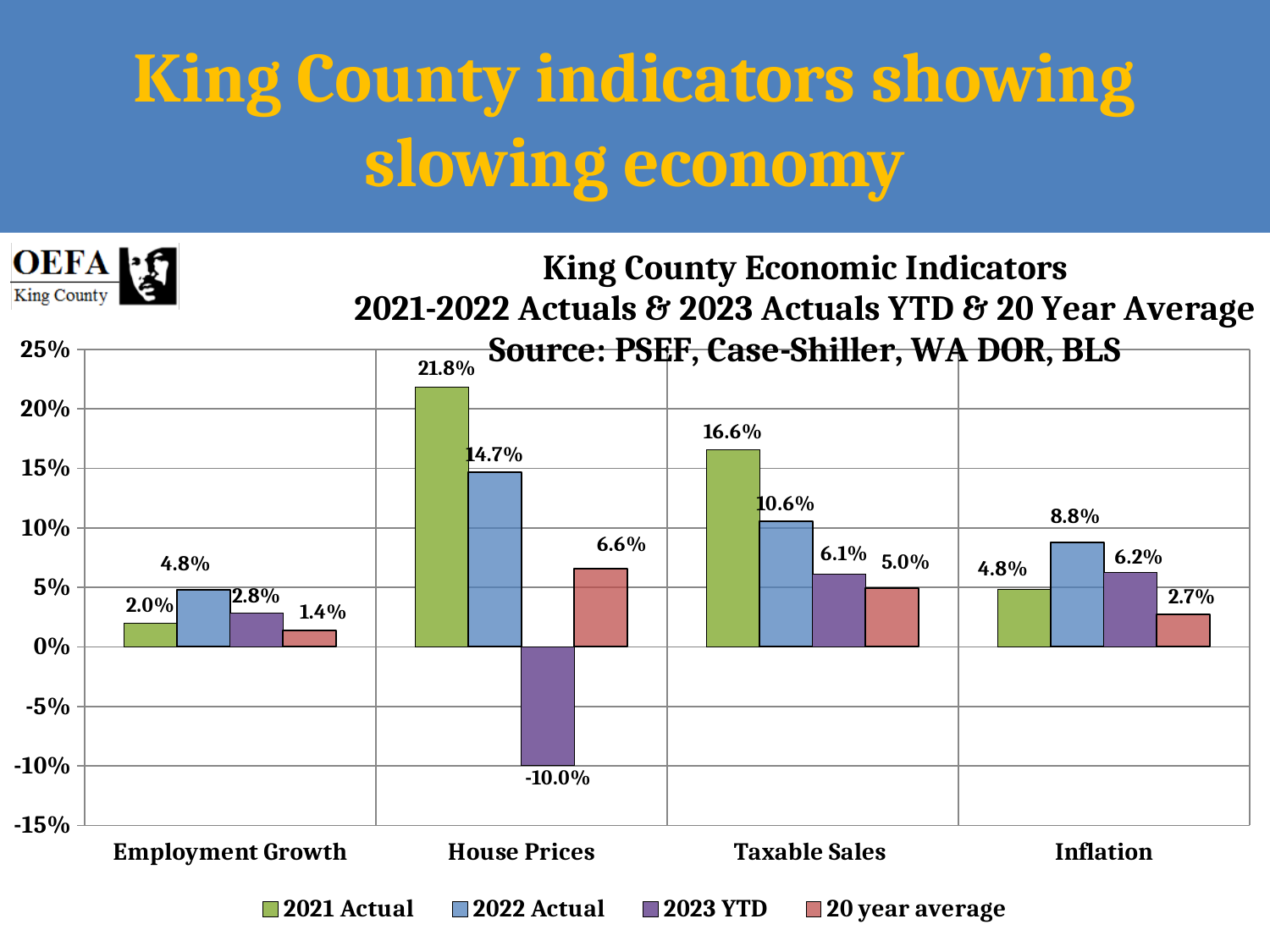
Which category has the lowest 2023 YTD value? House Prices Which is larger for Employment Growth: the 2022 Actual value or the 20 year average? 2022 Actual Which series is shown in purple in the legend? 2023 YTD What kind of chart is shown on the slide? Bar chart What is the 2022 Actual value for Inflation? 8.8% How many categories are shown on the x axis? 4 What is the 2023 YTD value for House Prices? -10.0% What is the difference between the 2021 Actual and 2022 Actual values for Taxable Sales? 6.0% What is the 20 year average value for Taxable Sales? 5.0% What is the 2021 Actual value for House Prices? 21.8% How many series does the legend list? 4 Which category has the highest 2021 Actual value? House Prices